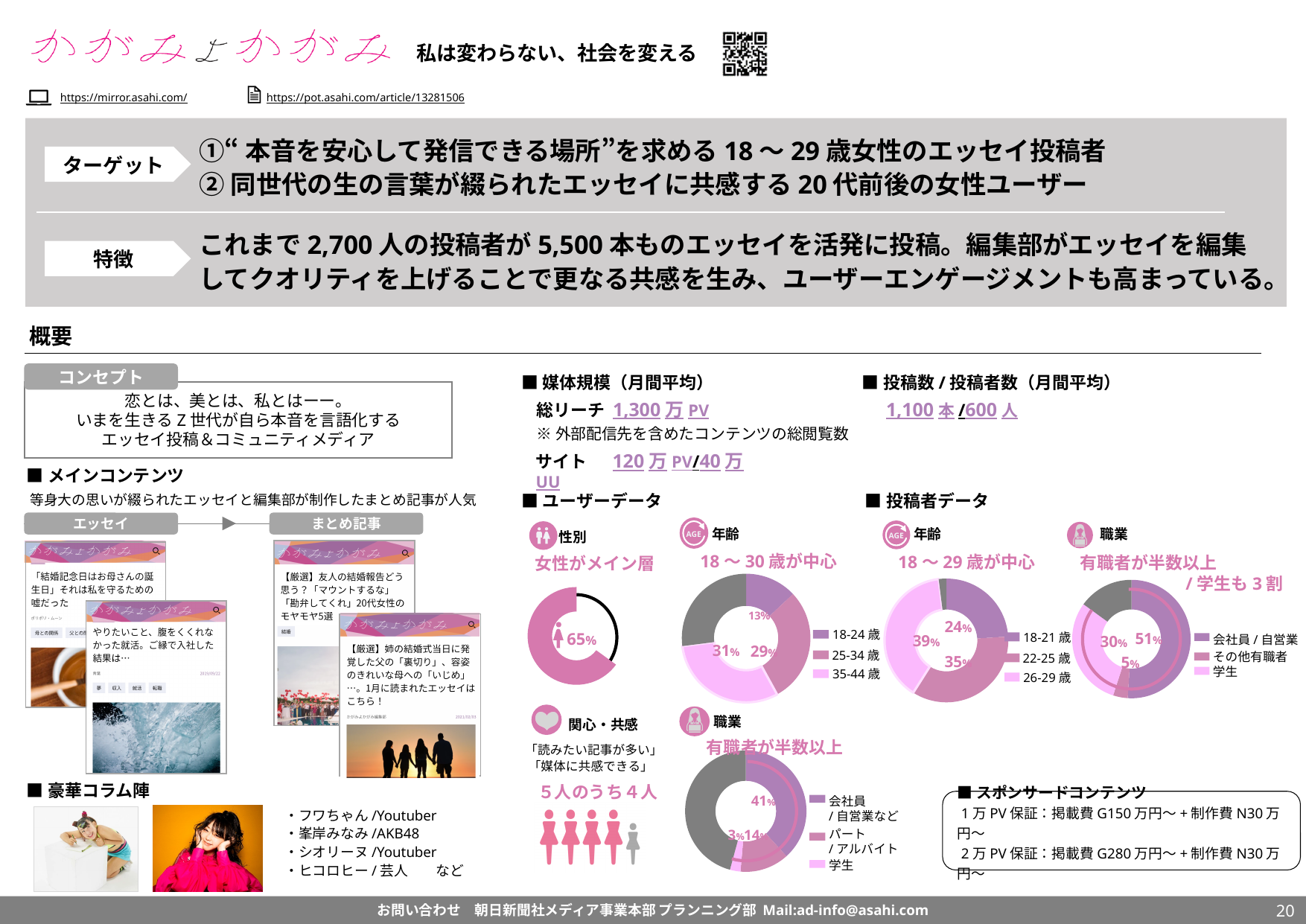
In the 投稿者データ 年齢 chart, what percentage is shown for 18-21歳? 24% In the ユーザーデータ 性別 chart, what percentage is shown for women? 65% What kind of chart is used for the 投稿者データ 職業 data? pie chart (donut) In the ユーザーデータ 職業 chart, what percentage is shown for 会社員/自営業など? 41% In the 投稿者データ 職業 chart, which labeled category has the smallest share? その他有職者 In the 投稿者データ 年齢 chart, what is the difference between the shares for 26-29歳 and 18-21歳? 15% How many age groups does the legend of the ユーザーデータ 年齢 chart list? 3 In the ユーザーデータ 職業 chart, which is larger: パート/アルバイト or 学生? パート/アルバイト In the 投稿者データ 職業 chart, what percentage is shown for 学生? 30% In the 投稿者データ 年齢 chart, what percentage is shown for 26-29歳? 39% In the 投稿者データ 職業 chart, what percentage is shown for 会社員/自営業? 51% In the 投稿者データ 年齢 chart, which age group has the largest share? 26-29歳